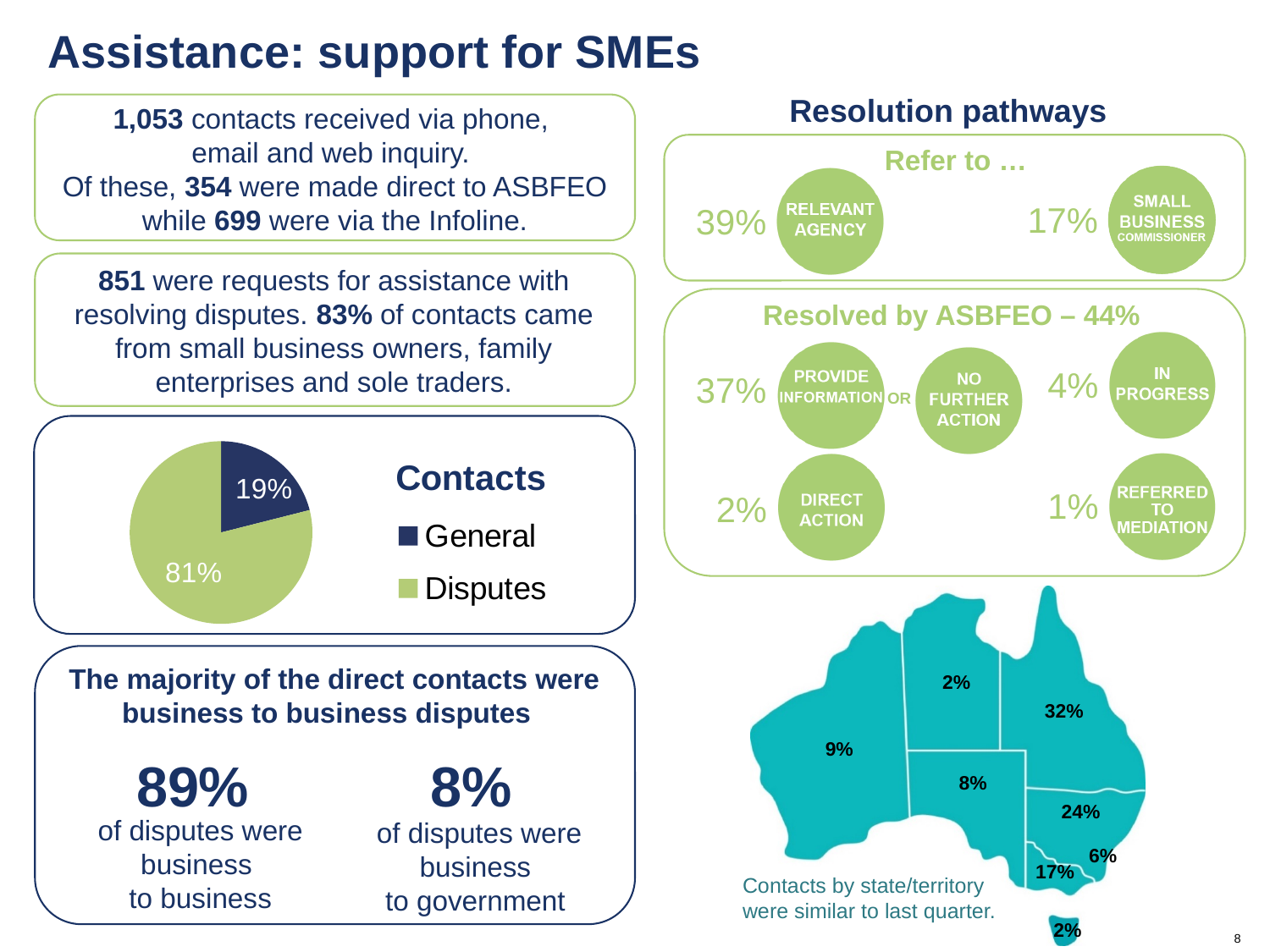
In the "Contacts" pie chart, what percentage of contacts were Disputes? 81% How many slices does the "Contacts" pie chart have? 2 What kind of chart is the "Contacts" chart on the slide? pie chart In the "Contacts" pie chart, what percentage of contacts were General? 19% In the "Contacts" pie chart, what colour is the General slice? dark blue In the "Contacts" pie chart, what is the difference in percentage points between Disputes and General? 62 In the "Contacts" pie chart, which is larger: General or Disputes? Disputes In the "Contacts" pie chart, which category has the largest share? Disputes In the "Contacts" pie chart, which category has the smallest share? General In the "Contacts" pie chart, what share of the pie does the Disputes slice take? 81% What is the title of the pie chart on the slide? Contacts How many categories does the legend of the "Contacts" pie chart list? 2